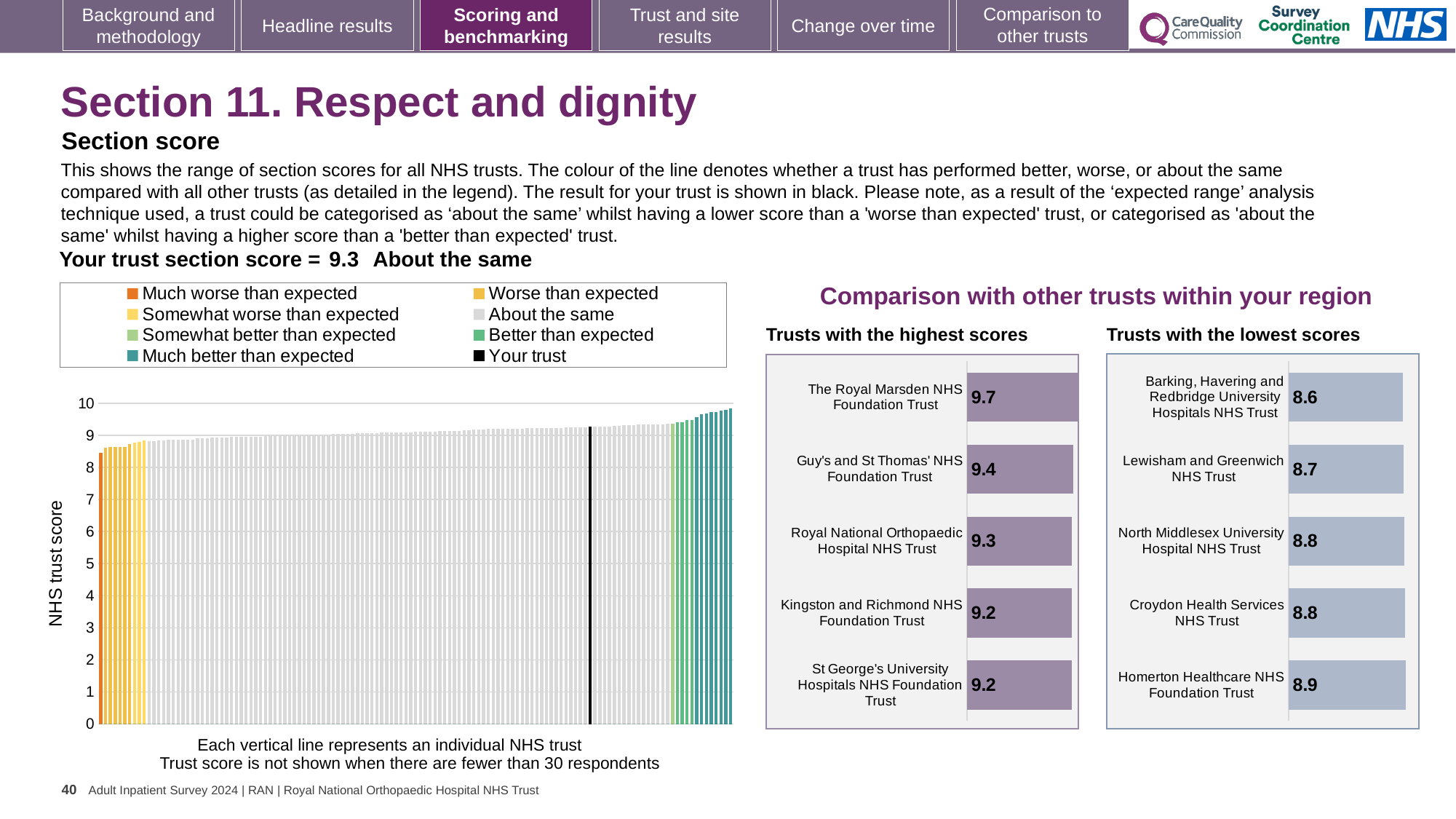
In the 'Trusts with the highest scores' chart, what is the difference between the scores of The Royal Marsden NHS Foundation Trust and Guy's and St Thomas' NHS Foundation Trust? 0.3 In the 'Trusts with the lowest scores' chart, what is the score for Lewisham and Greenwich NHS Trust? 8.7 In the 'Trusts with the highest scores' chart, what is the score for The Royal Marsden NHS Foundation Trust? 9.7 In the 'Trusts with the highest scores' chart, which trust has the highest score? The Royal Marsden NHS Foundation Trust How many entries does the legend of the NHS trust score chart list? 8 What kind of chart is the 'NHS trust score' chart on the left? Bar chart In the 'NHS trust score' chart, is the value for the black 'Your trust' bar greater or less than 9? greater In the 'Trusts with the lowest scores' chart, what is the difference between the scores of Homerton Healthcare NHS Foundation Trust and Barking, Havering and Redbridge University Hospitals NHS Trust? 0.3 How many trusts are shown in the 'Trusts with the lowest scores' chart? 5 In the 'NHS trust score' chart, do the bar values rise or fall from left to right? Rise In the 'Trusts with the lowest scores' chart, which trust has the lowest score? Barking, Havering and Redbridge University Hospitals NHS Trust In the 'Trusts with the highest scores' chart, which has the higher score: Guy's and St Thomas' NHS Foundation Trust or Royal National Orthopaedic Hospital NHS Trust? Guy's and St Thomas' NHS Foundation Trust